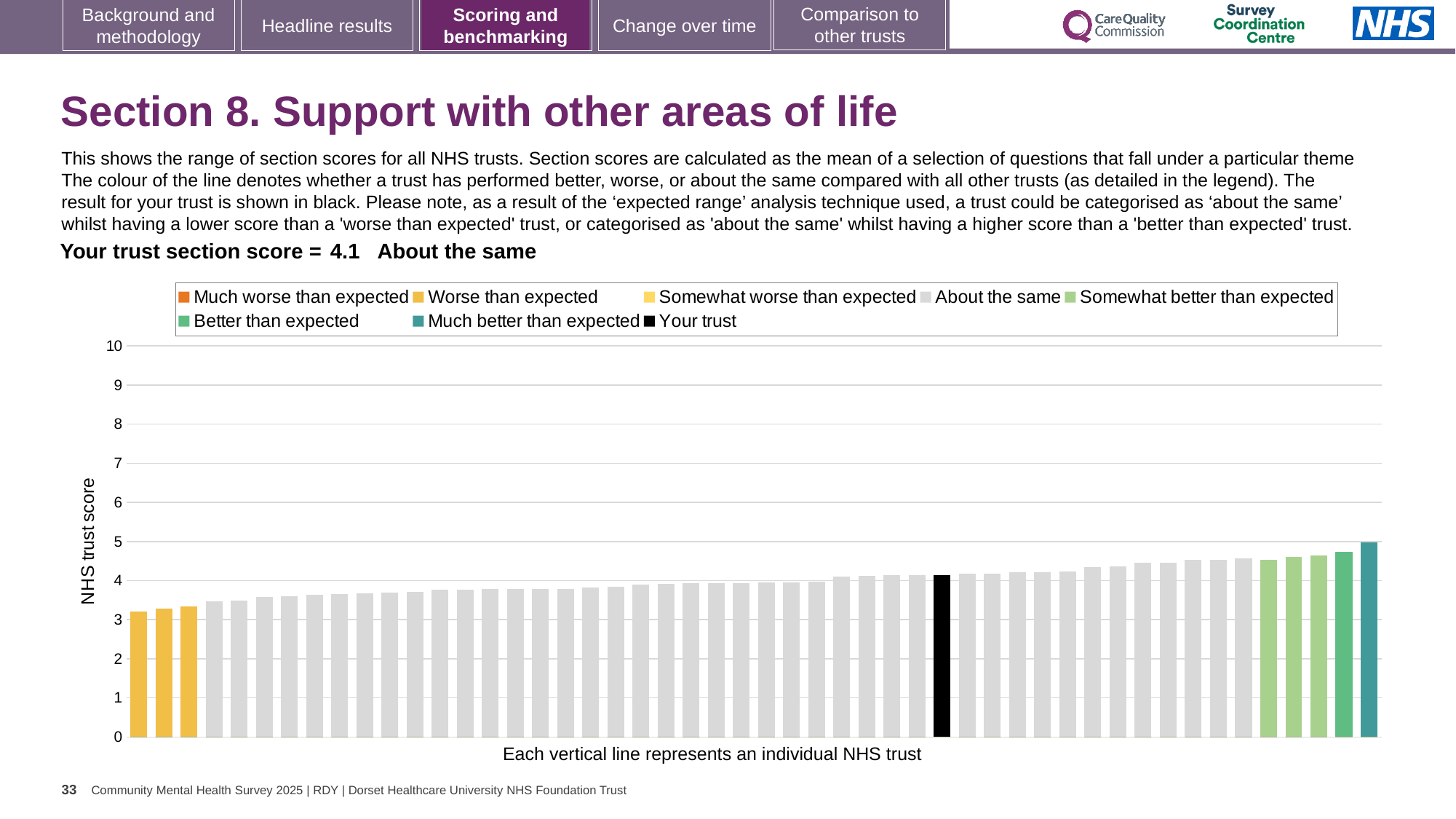
Do the bar values rise or fall from left to right along the x axis? rise What is the section score for your trust shown on the slide? 4.1 What kind of chart is shown on the slide? bar chart What is the highest value shown on the vertical axis? 10 Which category is your trust's section score placed in? About the same Is the value of the leftmost bar greater or less than 3? greater How many entries does the chart legend list? 8 Is the value of the rightmost (highest) bar greater or less than 4? greater What colour is the bar representing your trust? black What is the label of the vertical axis? NHS trust score How many bars are coloured as 'Worse than expected'? 3 Is the value of the leftmost (lowest) bar greater or less than 4? less